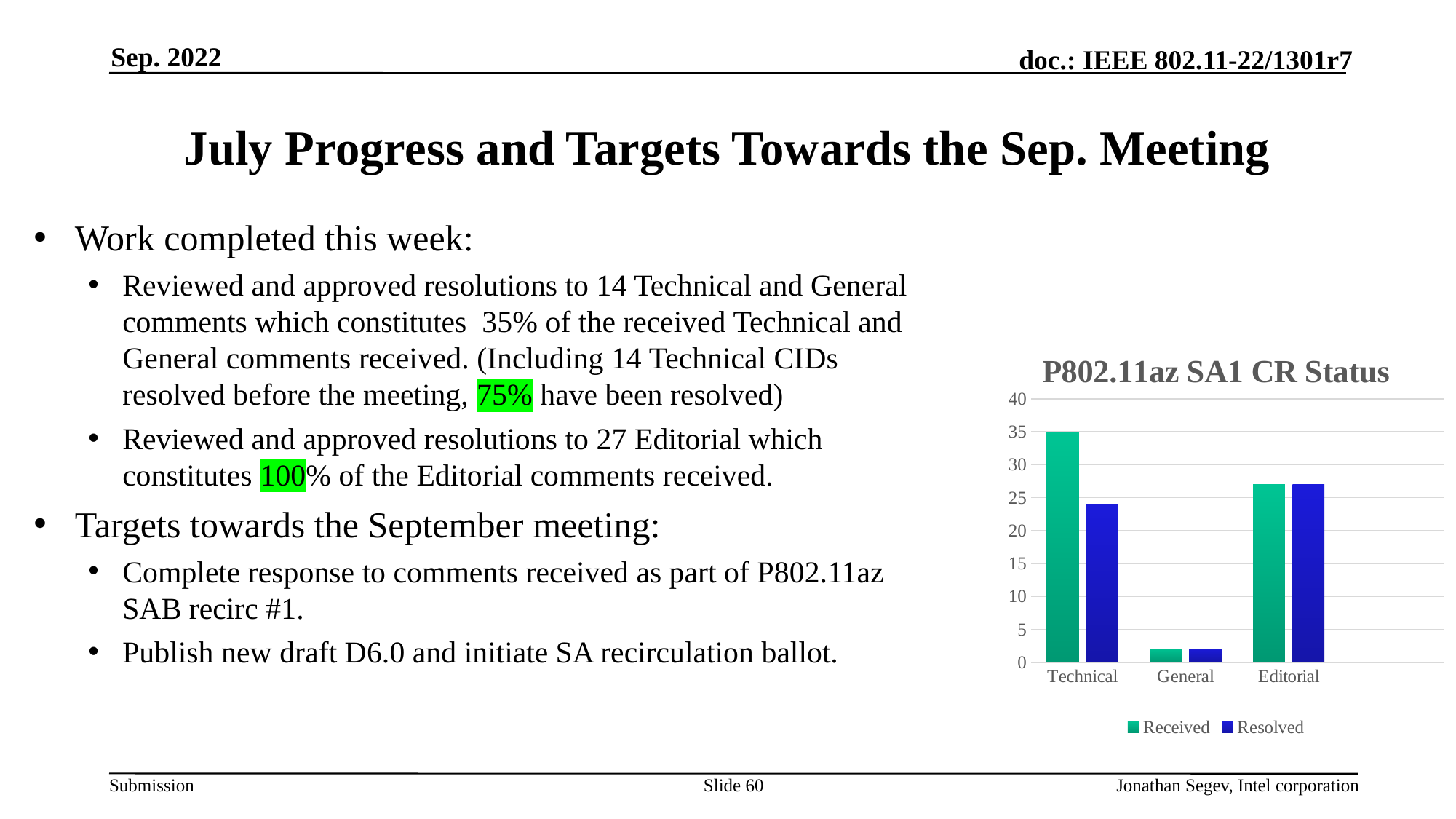
Which category has the highest Received value? Technical Is the Received value for General greater or less than 5? less Is the Resolved value for Technical greater or less than 20? greater Which category has the lowest Received value? General Is the Received value for Editorial greater or less than 25? greater What kind of chart is shown on the slide? bar chart How many categories are shown on the x axis of the chart? 3 Which series is shown in dark blue in the chart legend? Resolved How many series does the chart legend list? 2 What is the title of the chart? P802.11az SA1 CR Status For the Technical category, which is larger: Received or Resolved? Received